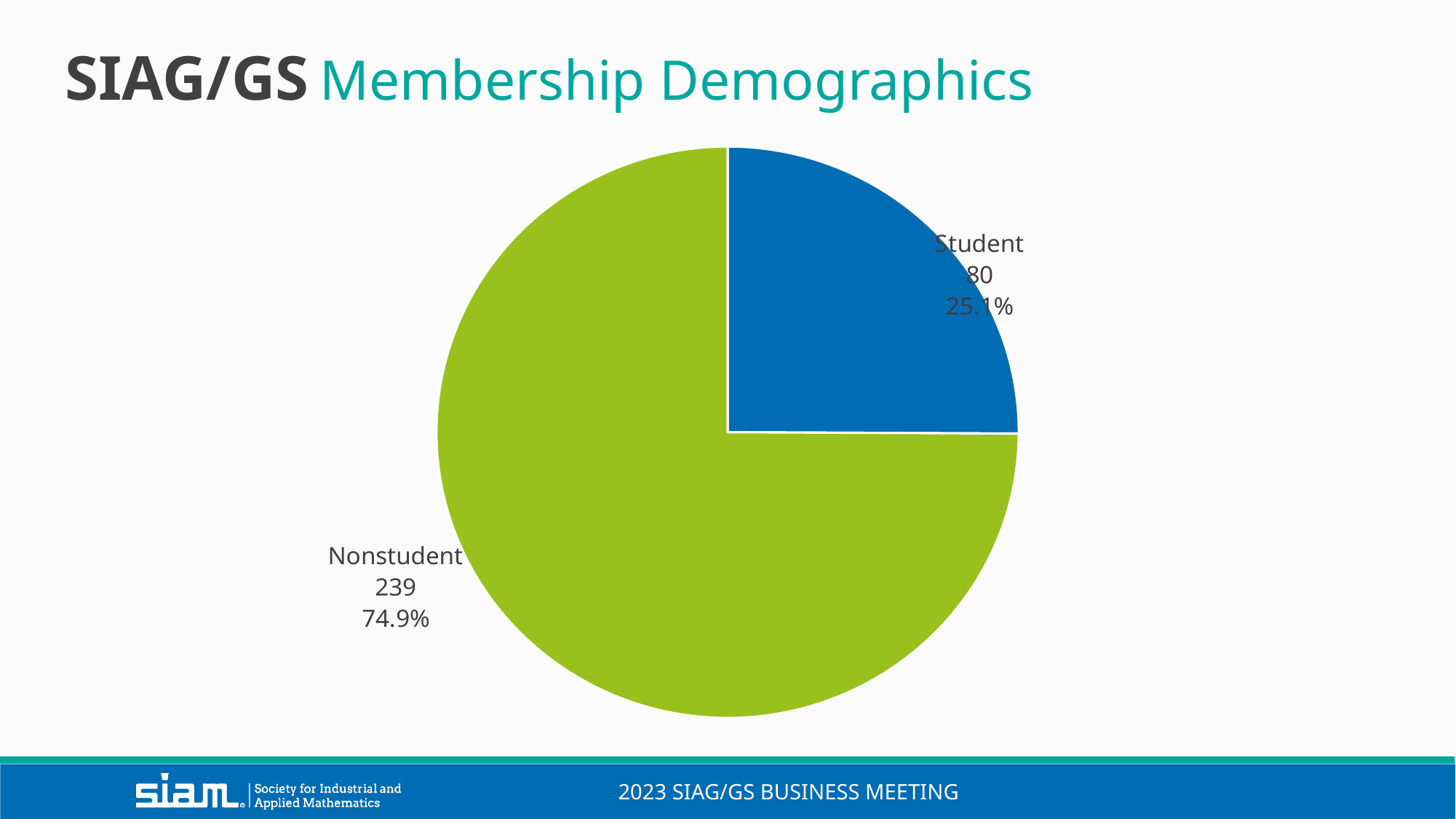
Which category has the largest slice of the pie? Nonstudent Which category has the smallest slice of the pie? Student How many categories are shown in the pie chart? 2 How many members are in the Student category? 80 What kind of chart is shown on the slide? pie chart What is the difference between the Nonstudent and Student member counts? 159 What is the total number of members across both slices? 319 Which is larger, the Student count or the Nonstudent count? Nonstudent What percentage of the pie does the Nonstudent slice represent? 74.9% How many members are in the Nonstudent category? 239 What colour is the Student slice? blue What percentage of the pie does the Student slice represent? 25.1%